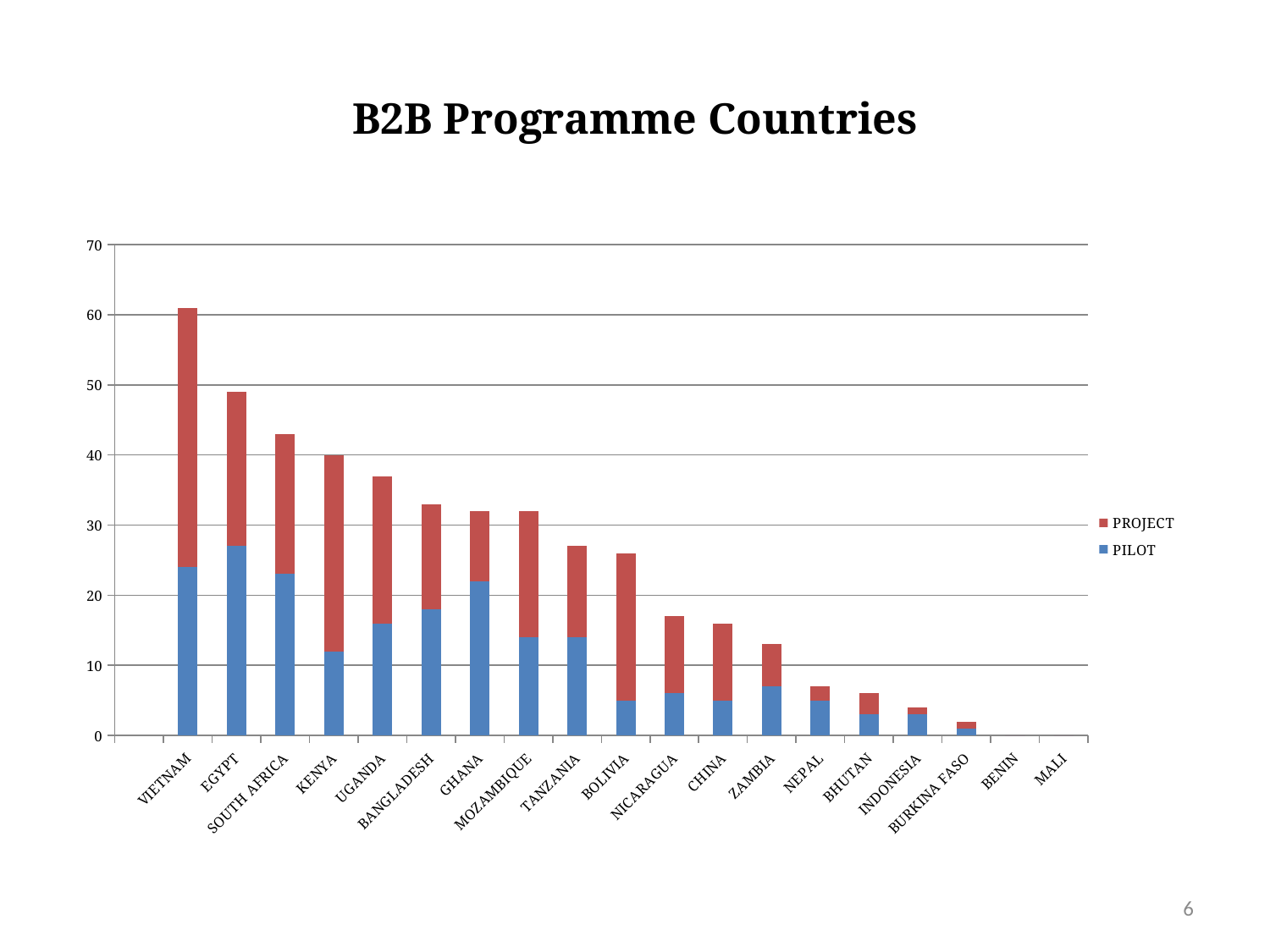
Which country has the tallest stacked bar? VIETNAM Is the total stacked value for EGYPT greater or less than 40? greater How many countries are shown on the x axis? 19 What are the two series named in the legend? PROJECT and PILOT How many series does the legend list? 2 What kind of chart is shown on the slide? bar chart Which country has the larger PILOT value, EGYPT or KENYA? EGYPT Is the total stacked value for VIETNAM greater or less than 50? greater Is the total stacked value for NEPAL greater or less than 10? less Do the stacked bar totals rise or fall from left to right along the x axis? fall Which has the larger total stacked bar, EGYPT or SOUTH AFRICA? EGYPT